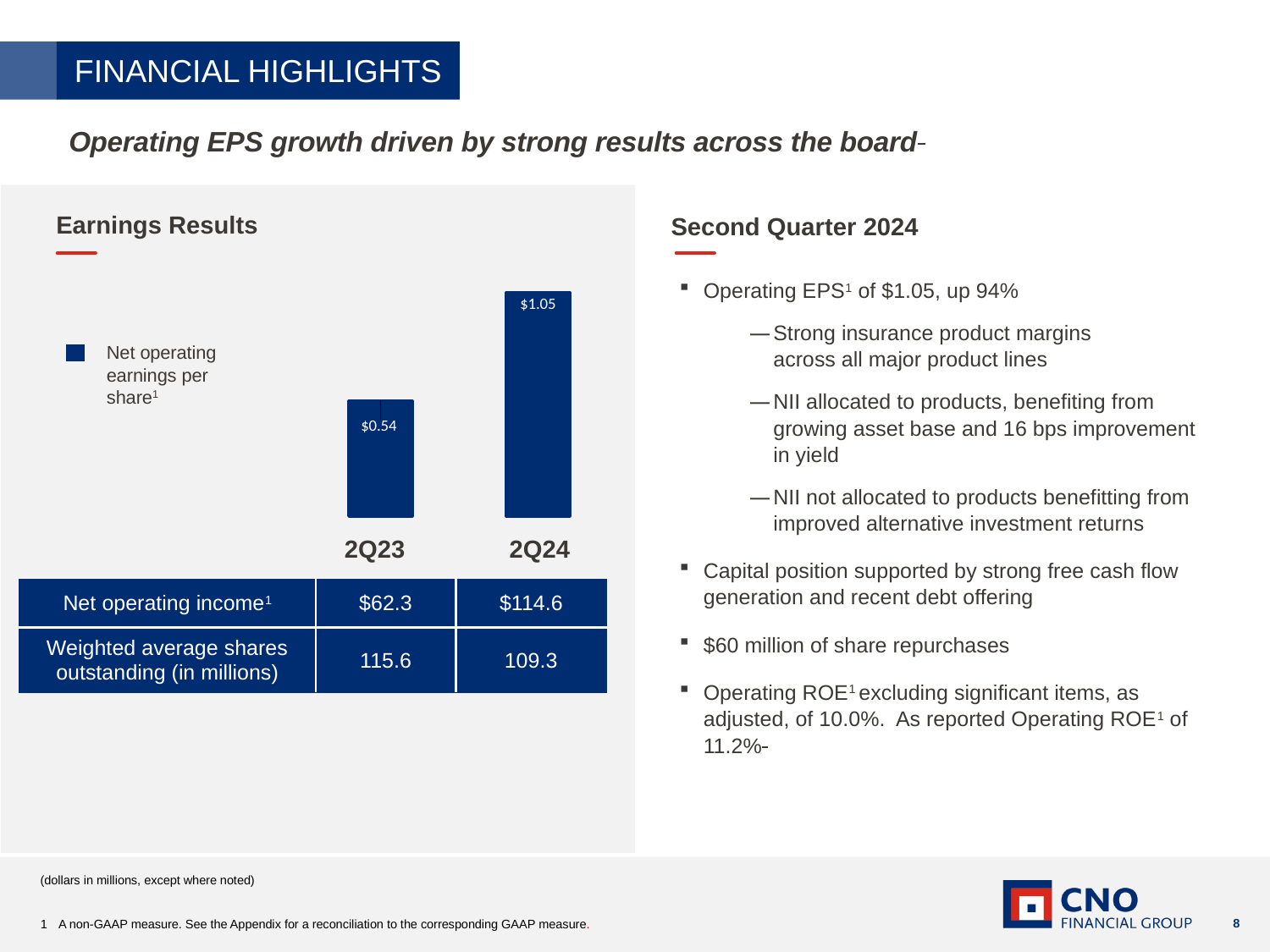
Which quarter has the higher net operating earnings per share in the chart? 2Q24 What is the difference between the 2Q24 and 2Q23 net operating earnings per share values? $0.51 What series name does the legend of the Earnings Results chart show? Net operating earnings per share What is the net operating earnings per share value shown for 2Q23? $0.54 What is the title of the chart on the left side of the slide? Earnings Results How many series does the legend of the Earnings Results chart list? 1 Is the net operating earnings per share larger in 2Q23 or 2Q24? 2Q24 What is the net operating earnings per share value shown for 2Q24? $1.05 Do the net operating earnings per share values rise or fall from 2Q23 to 2Q24? Rise How many quarters are plotted in the Earnings Results chart? 2 What kind of chart is used to show the Earnings Results? Bar chart Which quarter has the lower net operating earnings per share in the chart? 2Q23